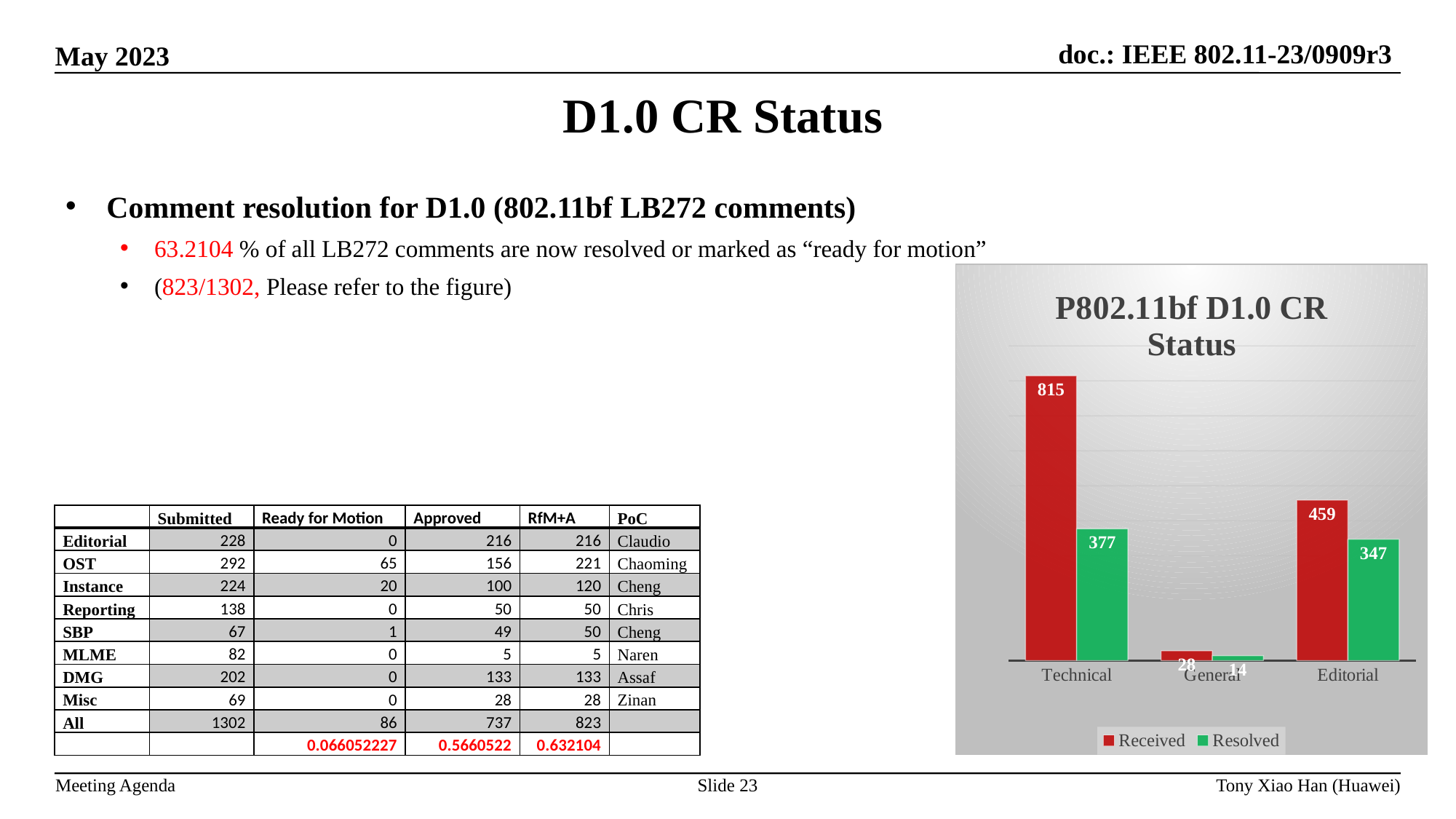
What is the title of the chart on the slide? P802.11bf D1.0 CR Status Which is larger, the Resolved value for Technical or the Resolved value for Editorial? Technical Which series is shown in red in the chart? Received What kind of chart is shown on the slide? bar chart Which category has the lowest Resolved value? General What is the Received value for General? 28 How many categories are shown on the x axis of the chart? 3 How many series does the chart legend list? 2 What is the Resolved value for Editorial? 347 Which category has the highest Received value? Technical What is the Received value for Technical? 815 What is the difference between Received and Resolved for Technical? 438